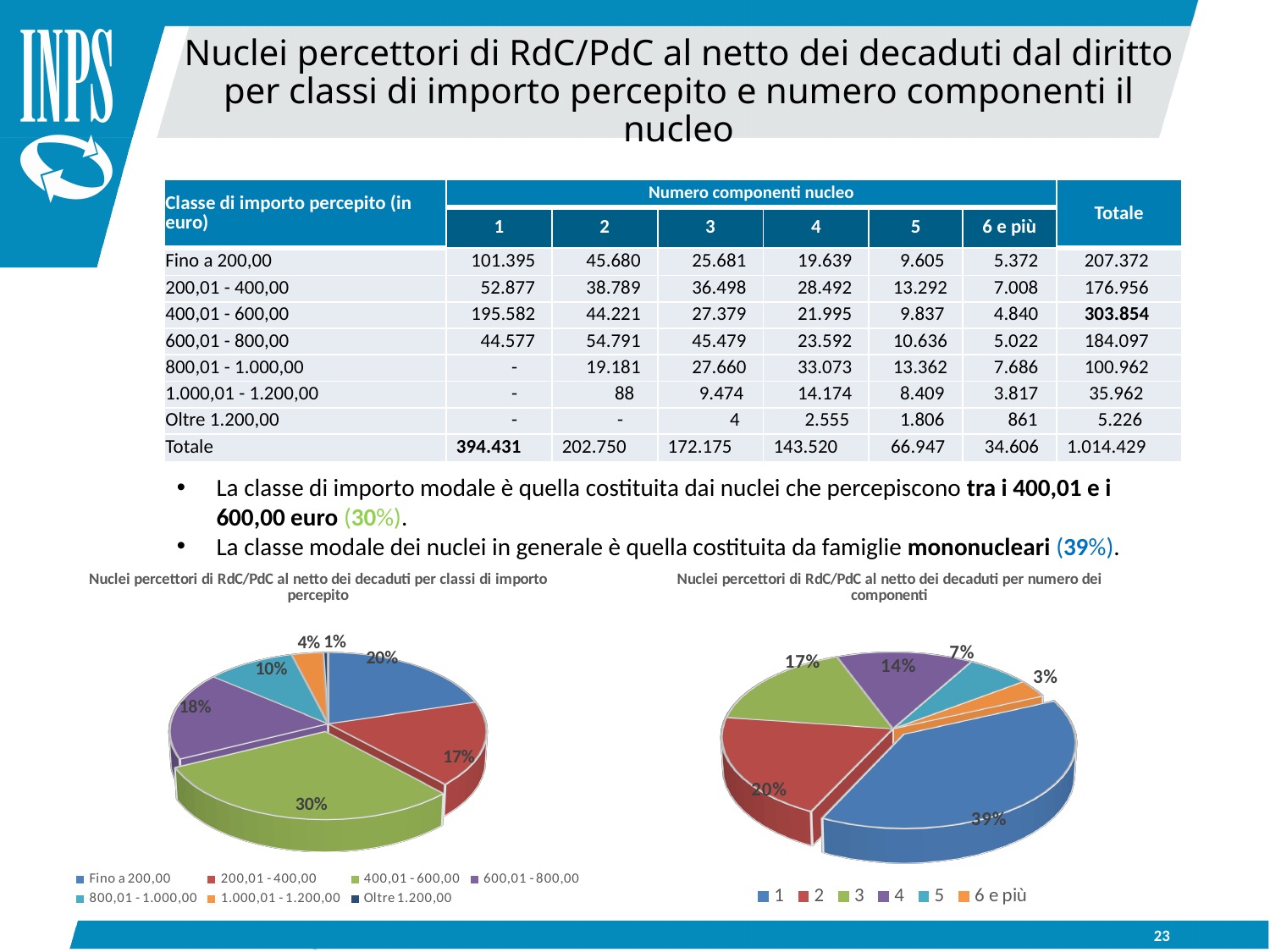
In the right pie chart (per numero dei componenti), how many categories does the legend list? 6 In the right pie chart (per numero dei componenti), what share is shown for households with 6 e più components? 3% In the right pie chart (per numero dei componenti), which is larger, the share for 2 components or the share for 3 components? 2 components In the left pie chart (per classi di importo percepito), what share is shown for the 400,01 - 600,00 class? 30% In the right pie chart (per numero dei componenti), what share is shown for households with 1 component? 39% In the left pie chart (per classi di importo percepito), what share is shown for the Fino a 200,00 class? 20% In the left pie chart (per classi di importo percepito), what is the difference between the shares of 600,01 - 800,00 and 800,01 - 1.000,00? 8% In the left pie chart (per classi di importo percepito), which class has the largest share? 400,01 - 600,00 In the left pie chart (per classi di importo percepito), how many classes are listed in the legend? 7 In the right pie chart (per numero dei componenti), which category has the largest share? 1 In the left pie chart (per classi di importo percepito), which class has the smallest share? Oltre 1.200,00 What type of chart is used for the two charts at the bottom of the slide? Pie chart